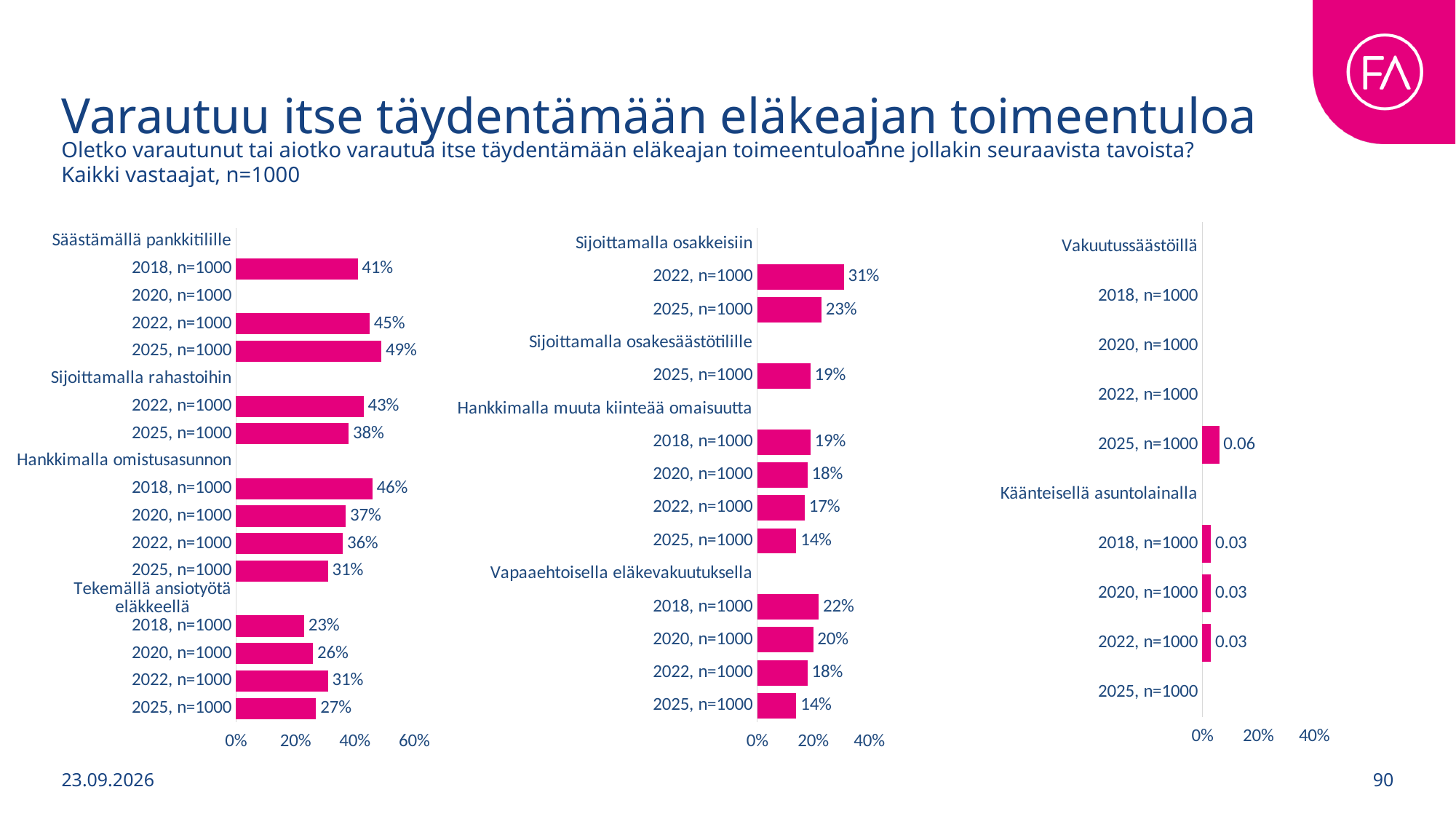
In the middle chart, which is larger: Hankkimalla muuta kiinteää omaisuutta in 2018 or Vapaaehtoisella eläkevakuutuksella in 2018? Vapaaehtoisella eläkevakuutuksella in 2018 In the middle chart, what is the value for Sijoittamalla osakesäästötilille in 2025, n=1000? 19% In the left chart, what is the value for Hankkimalla omistusasunnon in 2020, n=1000? 37% In the middle chart, what is the value for Sijoittamalla osakkeisiin in 2022, n=1000? 31% In the left chart, do the values for Hankkimalla omistusasunnon rise or fall from 2018 to 2025? fall In the left chart, what is the value for Säästämällä pankkitilille in 2025, n=1000? 49% In the left chart, what is the difference between the 2018 and 2025 values for Hankkimalla omistusasunnon? 15% In the middle chart, which year has the lowest value under Vapaaehtoisella eläkevakuutuksella? 2025, n=1000 In the right chart, what is the value for Vakuutussäästöillä in 2025, n=1000? 0.06 What type of chart is used on this slide? bar chart In the left chart, which year has the highest value under Tekemällä ansiotyötä eläkkeellä? 2022, n=1000 In the right chart, what is the value for Käänteisellä asuntolainalla in 2020, n=1000? 0.03